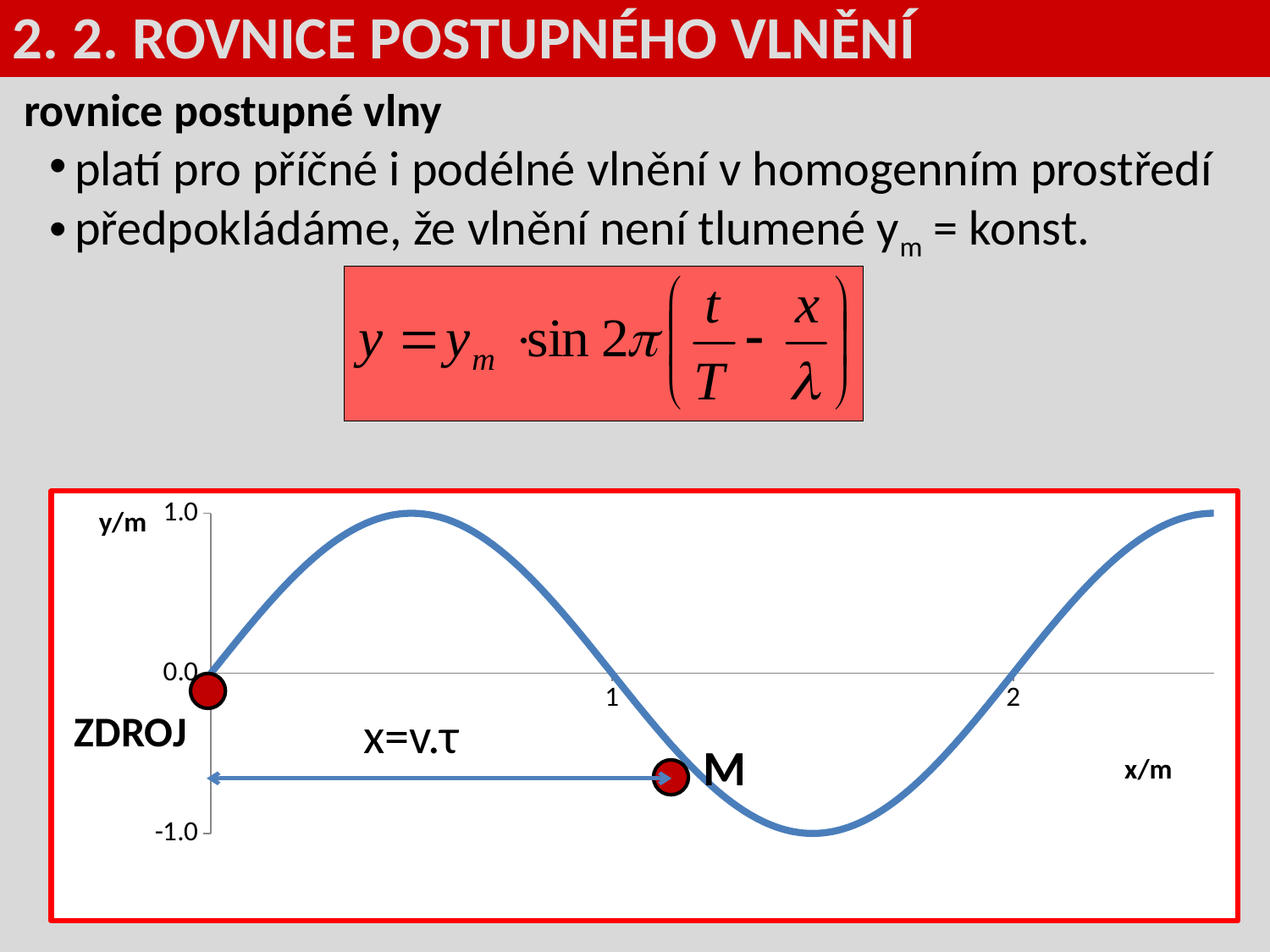
What is the value of y where the curve crosses the x axis at x = 2? 0.0 Does the curve rise or fall between x = 1 and x = 1.5? fall Is the value of y at the point M greater or less than 0.0? less Is the value of y at x = 0.5 greater or less than 0.0? greater What kind of chart is shown at the bottom of the slide? line chart How many numbered tick labels are shown on the x axis of the chart? 2 What is the value of y where the curve crosses the x axis at x = 1? 0.0 What is the highest value printed on the y axis of the chart? 1.0 What is the label of the horizontal axis of the chart? x/m What is the lowest value printed on the y axis of the chart? -1.0 What is the label of the vertical axis of the chart? y/m Is the value of y at x = 1.5 greater or less than 0.0? less